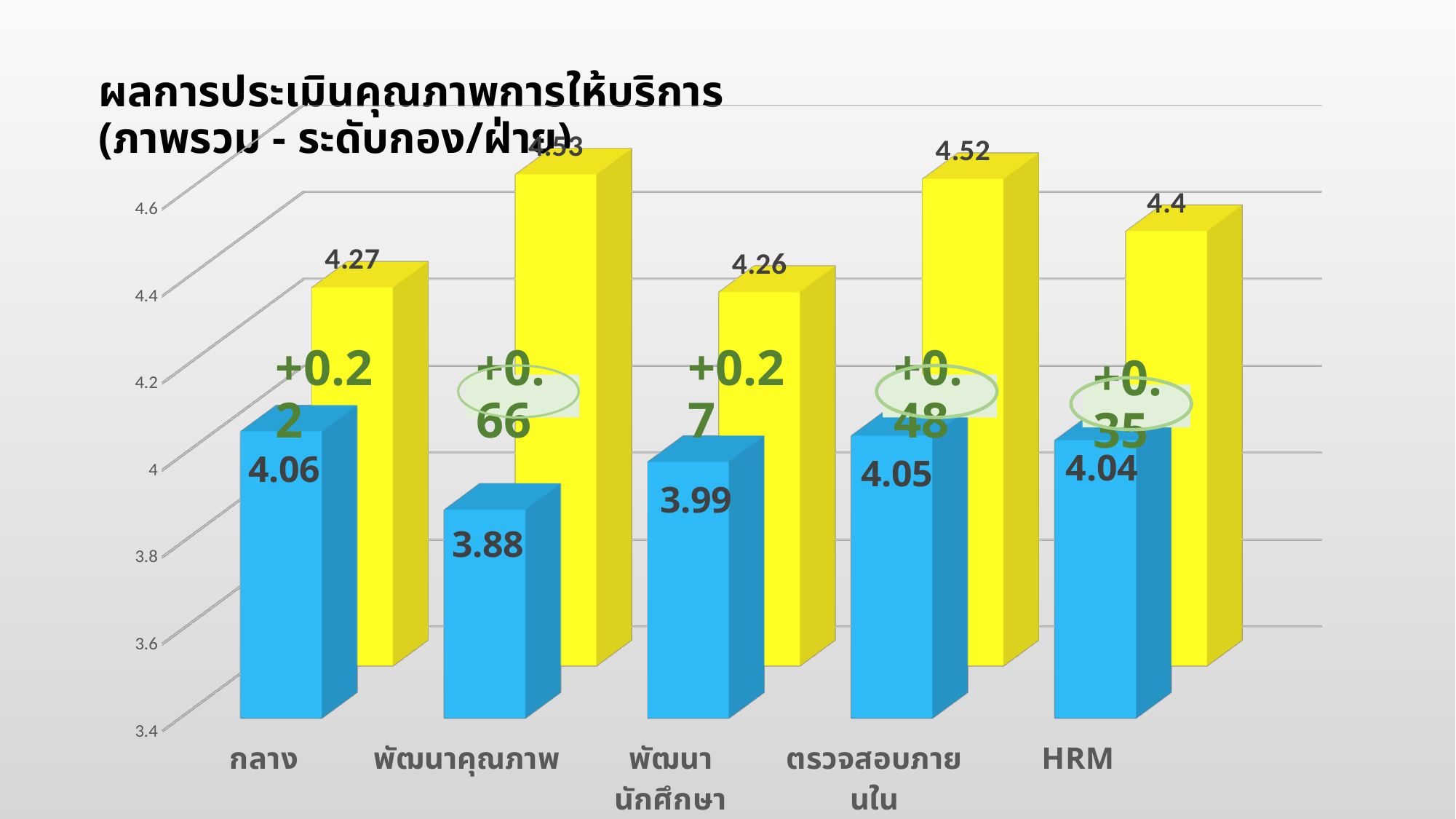
What is the value of the yellow bar for HRM? 4.4 Which category has the lowest blue bar? พัฒนาคุณภาพ Which is larger, the blue bar for กลาง or the blue bar for พัฒนาคุณภาพ? กลาง What is the value of the blue bar for พัฒนาคุณภาพ? 3.88 Which is larger, the yellow bar for HRM or the yellow bar for ตรวจสอบภายใน? ตรวจสอบภายใน What is the value of the blue bar for กลาง? 4.06 What kind of chart is shown on the slide? bar chart How many categories are shown on the x axis? 5 Is the value of the yellow bar for HRM greater or less than 4.2? greater What is the value of the yellow bar for ตรวจสอบภายใน? 4.52 What increase is annotated in green for พัฒนาคุณภาพ? +0.66 What is the value of the blue bar for พัฒนานักศึกษา? 3.99